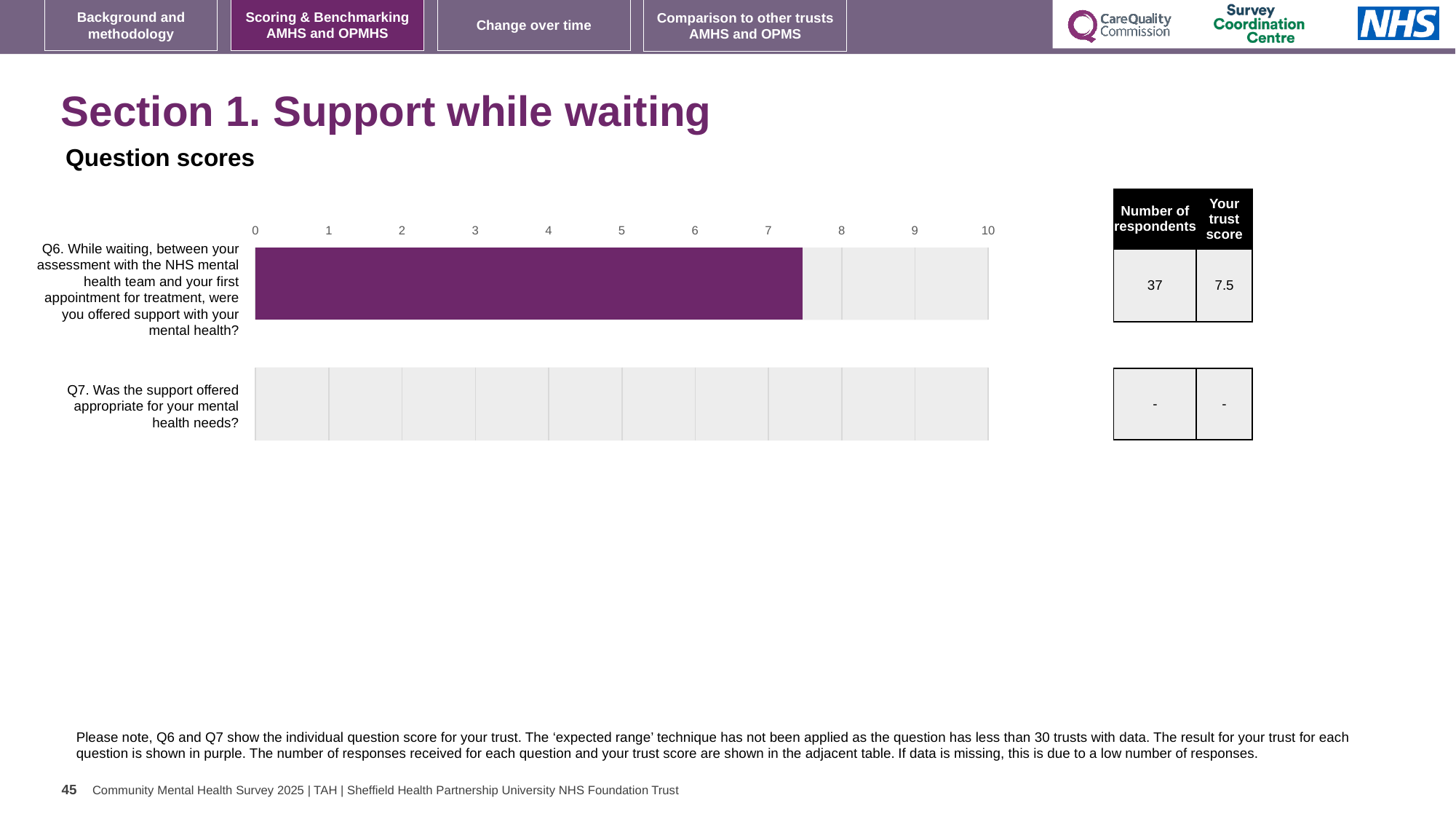
How many respondents are listed for Q6? 37 What is the trust score for Q6 shown in the adjacent table? 7.5 What is shown as the trust score for Q7? - What colour is the bar showing the trust's result for Q6? purple Is the bar for Q6 greater or less than 8 on the axis? less What kind of chart is shown under 'Question scores'? bar chart How many questions (categories) are plotted in the chart? 2 Which question has a plotted bar with a score in the chart? Q6 What is the maximum value shown on the chart's axis? 10 Is the bar for Q6 greater or less than 7 on the axis? greater